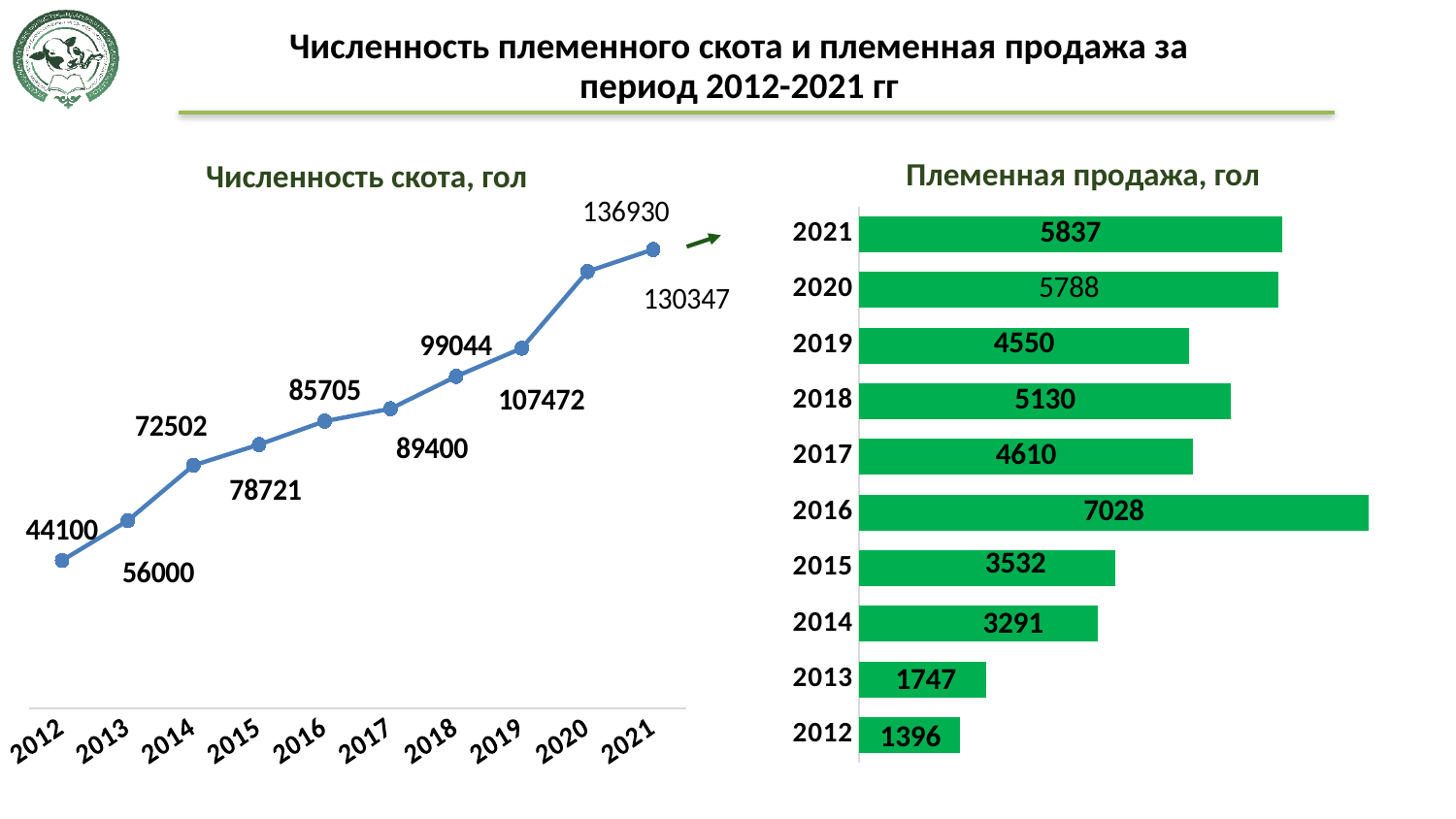
What kind of chart is 'Численность скота, гол'? line chart In the chart 'Численность скота, гол', what is the value for 2012? 44100 In the chart 'Численность скота, гол', do the values rise or fall from 2012 to 2021? rise In the chart 'Численность скота, гол', what is the difference between the values for 2021 and 2020? 6583 In the chart 'Племенная продажа, гол', which year has the lowest value? 2012 In the chart 'Племенная продажа, гол', how many years are shown? 10 What kind of chart is 'Племенная продажа, гол'? bar chart In the chart 'Племенная продажа, гол', what is the value for 2016? 7028 In the chart 'Племенная продажа, гол', what is the difference between the values for 2021 and 2012? 4441 In the chart 'Численность скота, гол', what is the value for 2021? 136930 In the chart 'Племенная продажа, гол', which year has the highest value? 2016 In the chart 'Численность скота, гол', what is the value for 2017? 89400